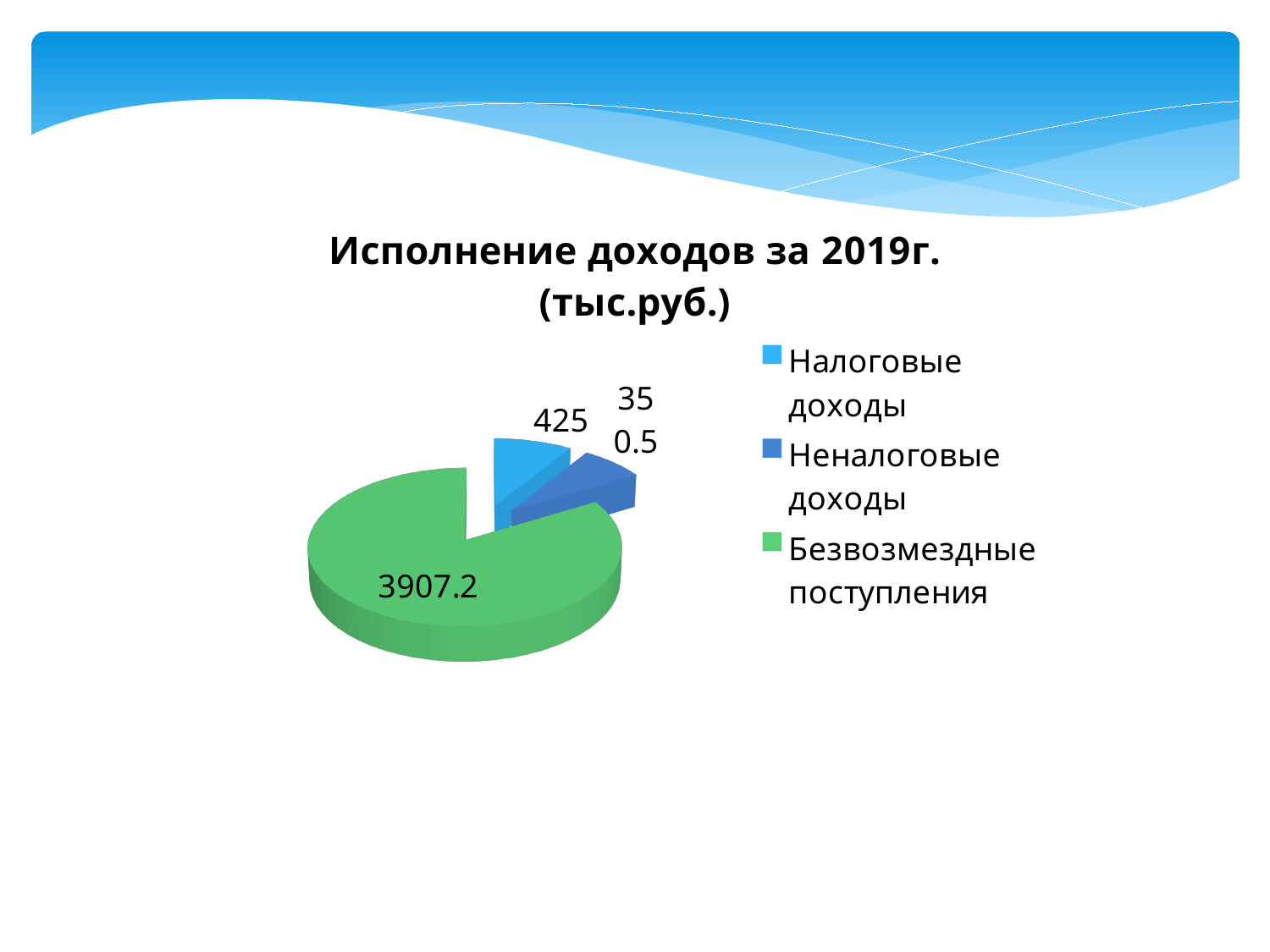
What is the difference between the values for Безвозмездные поступления and Налоговые доходы? 3482.2 Which is larger, Безвозмездные поступления or Налоговые доходы? Безвозмездные поступления What is the value for Безвозмездные поступления? 3907.2 What colour is the slice for Безвозмездные поступления? Green What is the value for Налоговые доходы? 425 What is the title of the chart? Исполнение доходов за 2019г. (тыс.руб.) What kind of chart is shown on the slide? Pie chart How many slices does the pie chart have? 3 Which category has the highest value? Безвозмездные поступления How many entries does the legend list? 3